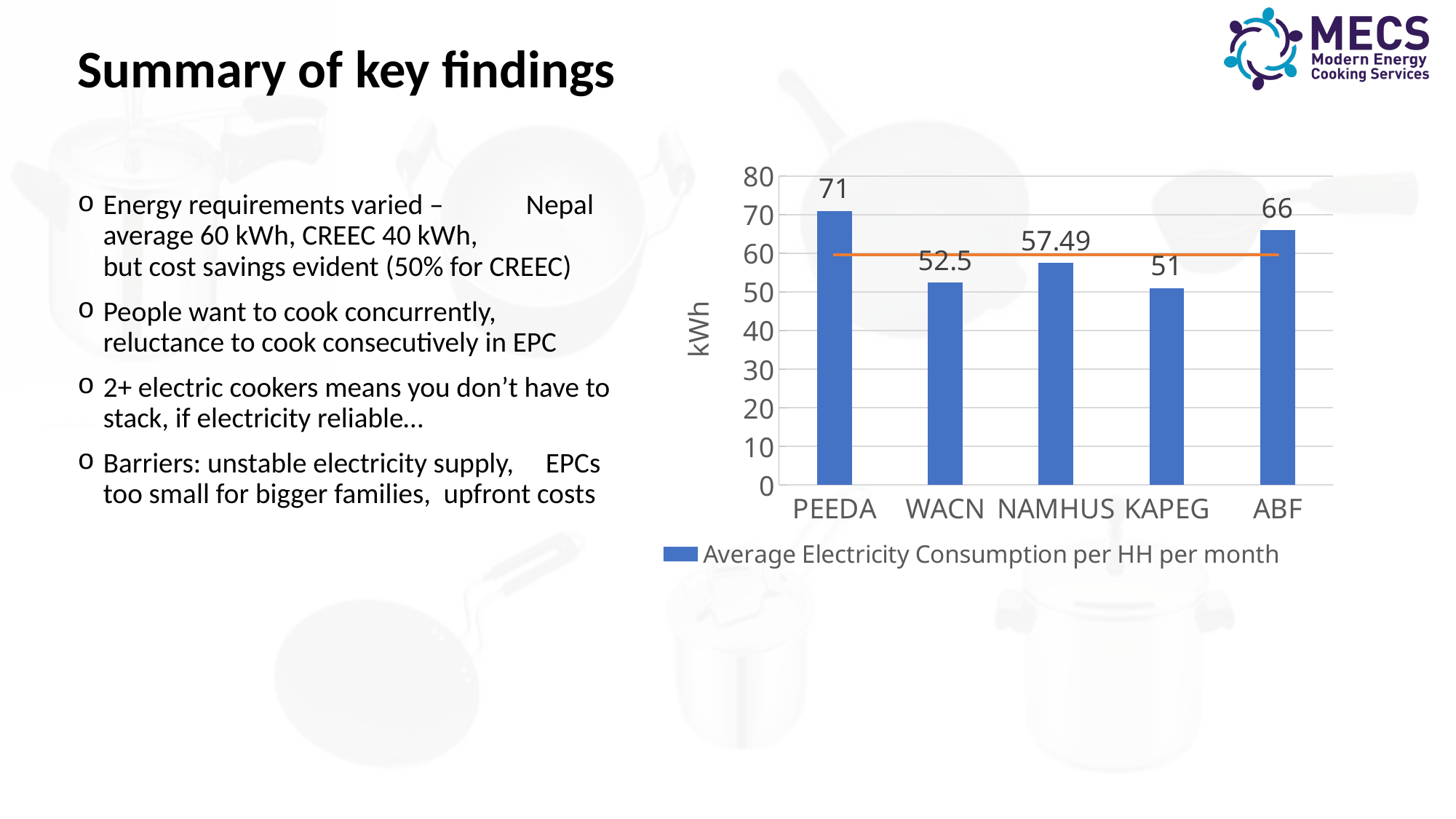
Which category has the highest average electricity consumption per HH per month? PEEDA What is the label on the vertical axis of the chart? kWh What is the average electricity consumption per HH per month for NAMHUS? 57.49 What is the average electricity consumption per HH per month for PEEDA? 71 What is the average electricity consumption per HH per month for KAPEG? 51 Is the value for NAMHUS greater or less than 60? less What kind of chart is shown on the slide? combination bar and line chart Which category has the lowest average electricity consumption per HH per month? KAPEG What is the difference between the values for PEEDA and ABF? 5 Which has a larger value, WACN or ABF? ABF How many categories are shown on the x axis of the chart? 5 What is the difference between the values for WACN and KAPEG? 1.5